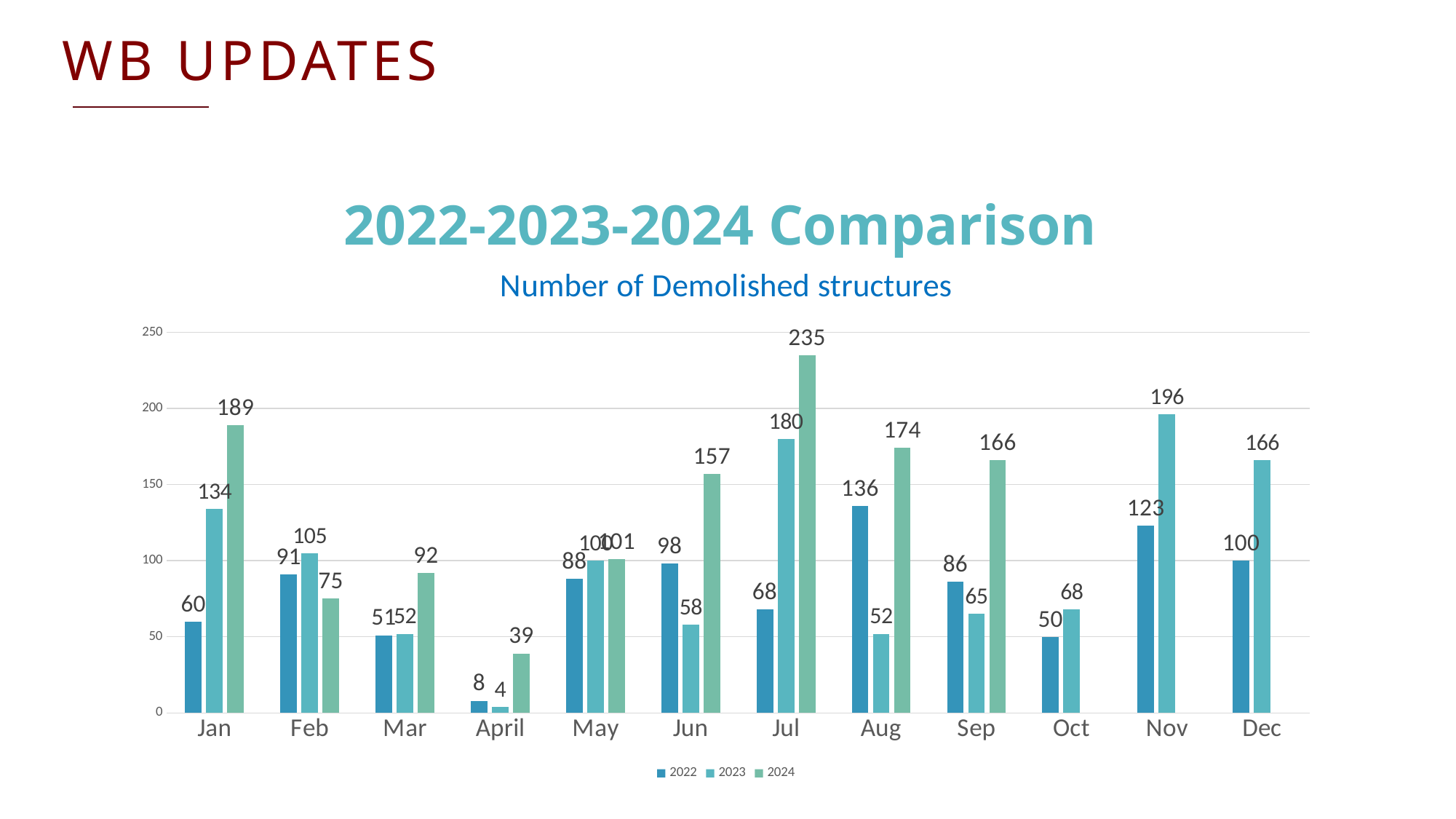
What kind of chart is shown on the slide? bar chart What is the value for 2023 in Nov? 196 In Feb, which series has the larger value, 2023 or 2024? 2023 How many series does the legend list? 3 What is the difference between the 2024 and 2023 values in Jul? 55 Is the value for 2024 in Sep greater or less than 150? greater What is the difference between the 2024 and 2022 values in Jan? 129 What is the value for 2022 in Aug? 136 How many months are shown on the x axis? 12 Which month has the highest value for the 2024 series? Jul Which month has the lowest value for the 2023 series? April What is the value for 2024 in Jul? 235